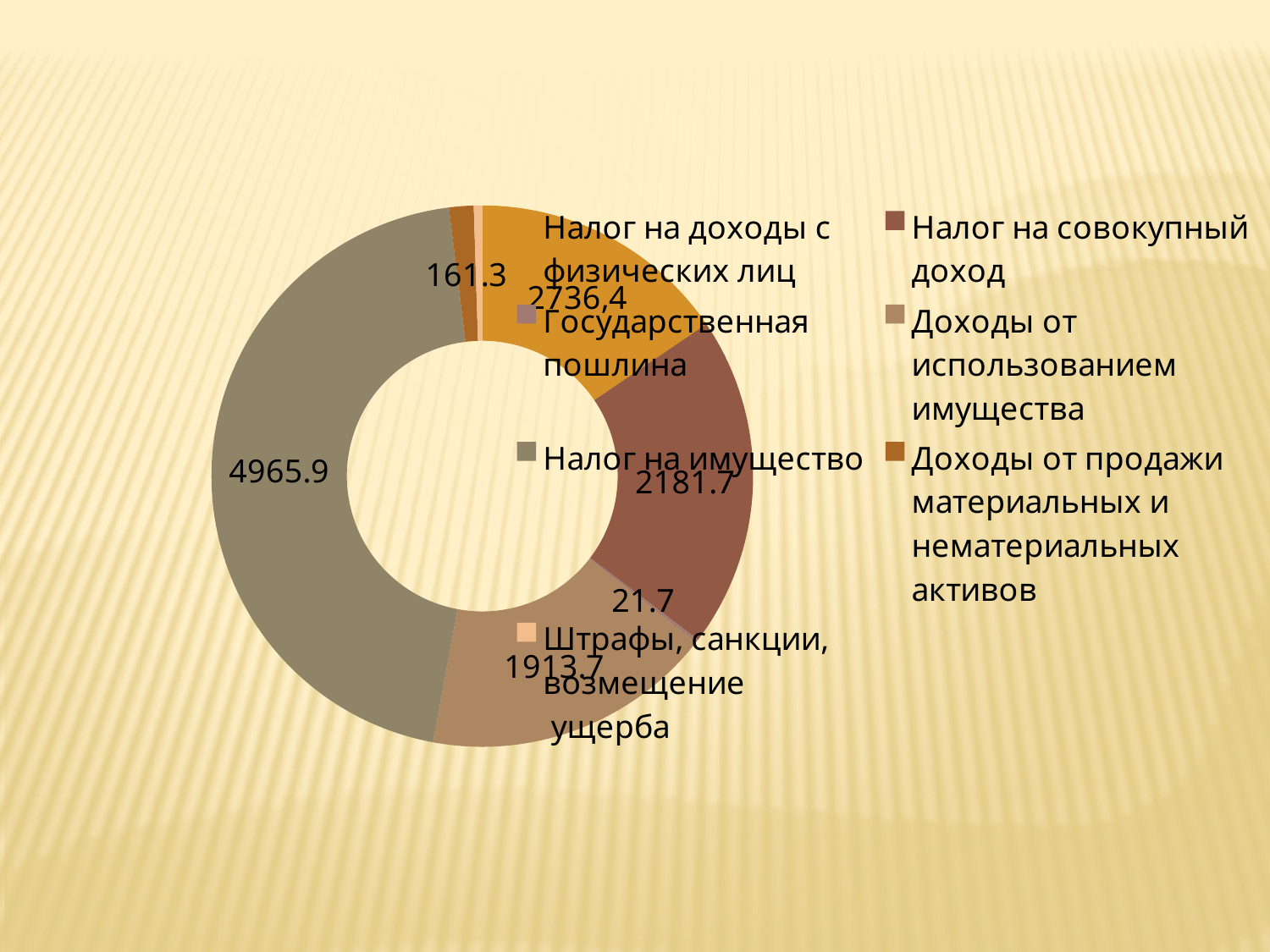
What is the value for Доходы от использованием имущества? 1913.7 Which is larger: Налог на совокупный доход or Доходы от использованием имущества? Налог на совокупный доход What is the value for Доходы от продажи материальных и нематериальных активов? 161.3 Which category has the largest slice? Налог на имущество What kind of chart is shown on the slide? Doughnut (pie) chart What is the difference between Налог на совокупный доход and Доходы от использованием имущества? 268.0 What is the value for Налог на совокупный доход? 2181.7 What is the difference between Налог на имущество and Налог на доходы с физических лиц? 2229.5 What is the value for Налог на имущество? 4965.9 What is the value for Налог на доходы с физических лиц? 2736,4 What is the value for Государственная пошлина? 21.7 How many categories does the legend list? 7